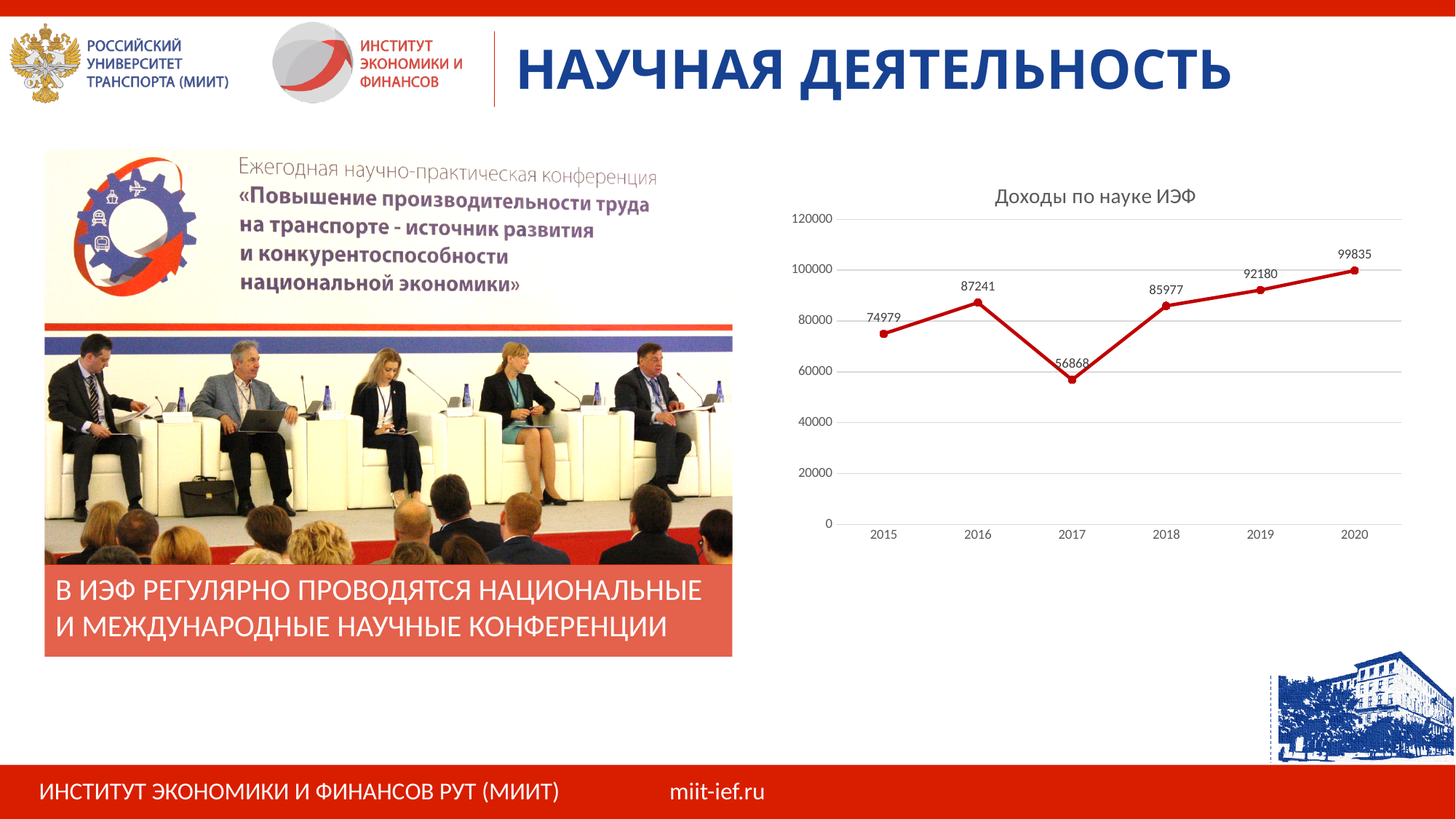
What is the title of the chart? Доходы по науке ИЭФ Which year has the lowest value in the chart? 2017 What kind of chart is shown on the slide? line chart Which year has the highest value in the chart? 2020 What is the difference between the values for 2016 and 2017? 30373 How many years are plotted in the chart? 6 What is the difference between the values for 2020 and 2019? 7655 Is the value for 2017 greater or less than 60000? less Which is larger, the value for 2016 or the value for 2018? 2016 What is the value for 2020 in the chart? 99835 What is the value for 2017 in the chart? 56868 What is the value for 2015 in the chart? 74979